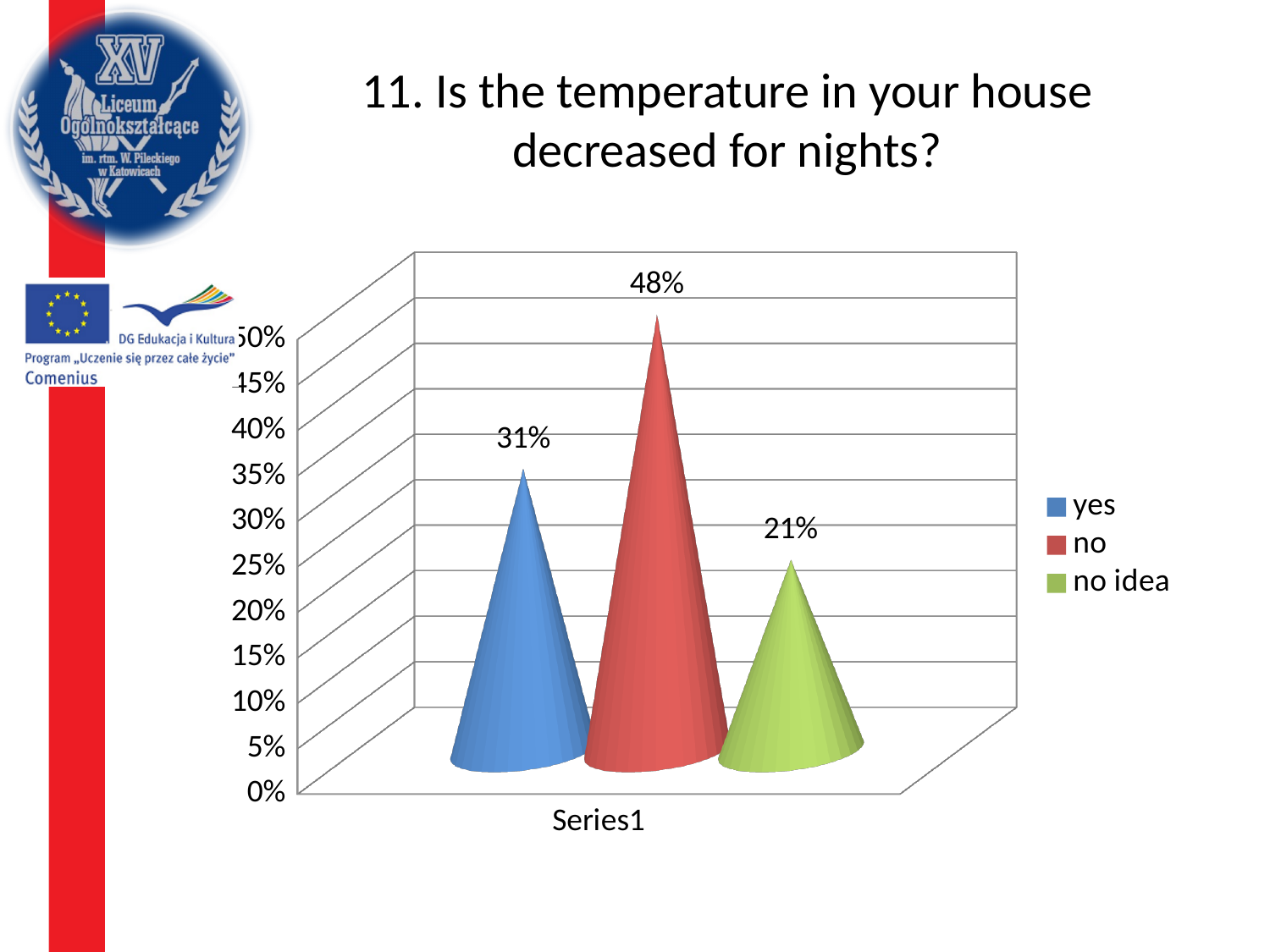
Which is larger, the value for "yes" or the value for "no idea"? yes What is the difference in percentage points between "yes" and "no idea"? 10 Which answer has the highest percentage? no What colour represents the "no" answer in the chart? red Which answer has the lowest percentage? no idea Is the value for "no" greater or less than 40%? greater What percentage of respondents answered "yes"? 31% What percentage of respondents answered "no idea"? 21% How many entries does the legend list? 3 What percentage of respondents answered "no"? 48% What kind of chart is shown on the slide? bar chart What is the difference in percentage points between "no" and "yes"? 17